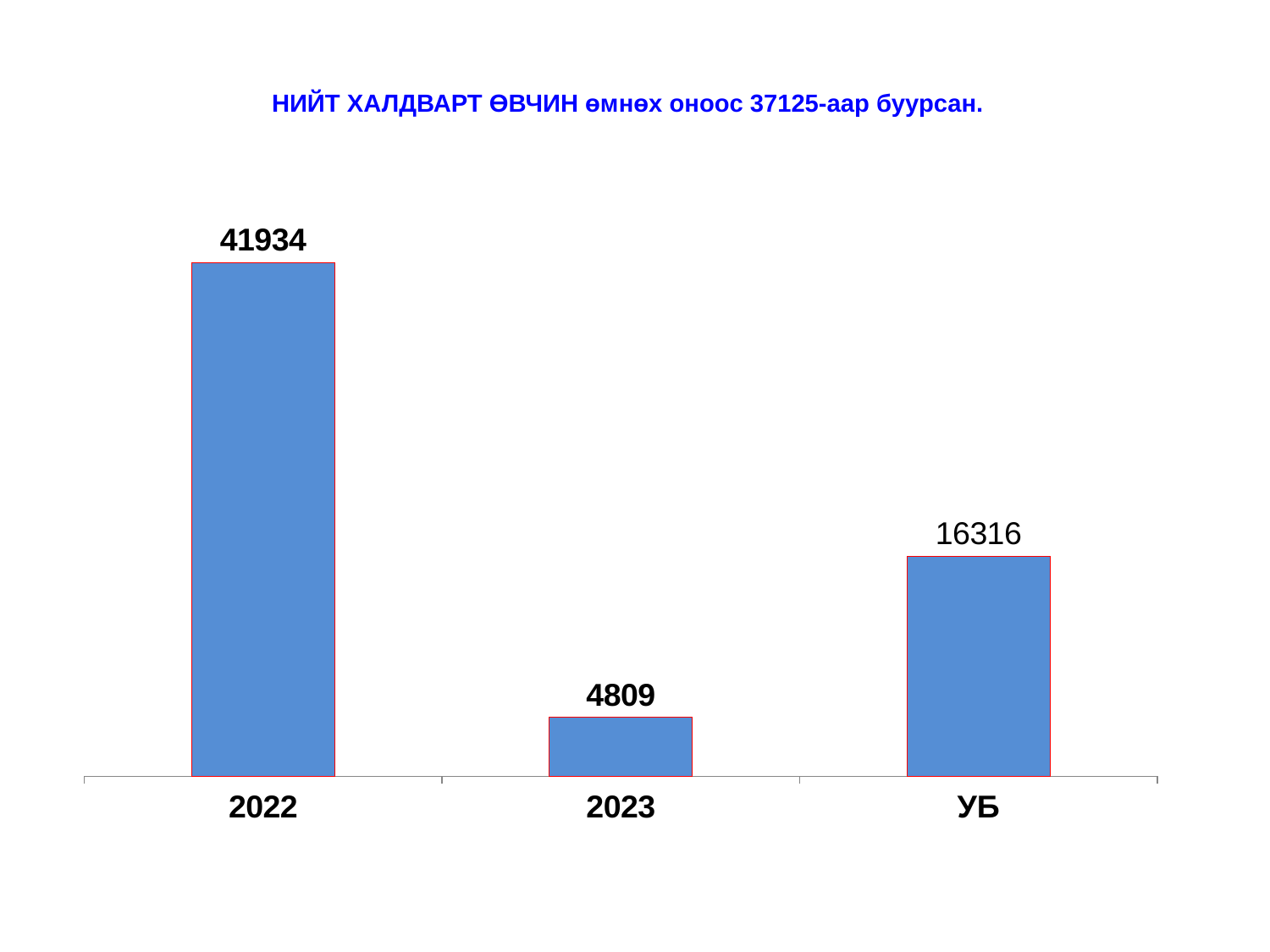
What is the value for УБ? 16316 What colour are the bars in the chart? blue What is the difference between the values for 2022 and 2023? 37125 What is the value for 2022? 41934 What kind of chart is shown on the slide? bar chart What is the title of the slide? НИЙТ ХАЛДВАРТ ӨВЧИН өмнөх оноос 37125-аар буурсан. What is the difference between the values for УБ and 2023? 11507 Which category has the lowest value? 2023 What is the value for 2023? 4809 How many categories are shown on the x axis? 3 Which category has the highest value? 2022 Which is larger, the value for УБ or the value for 2023? УБ